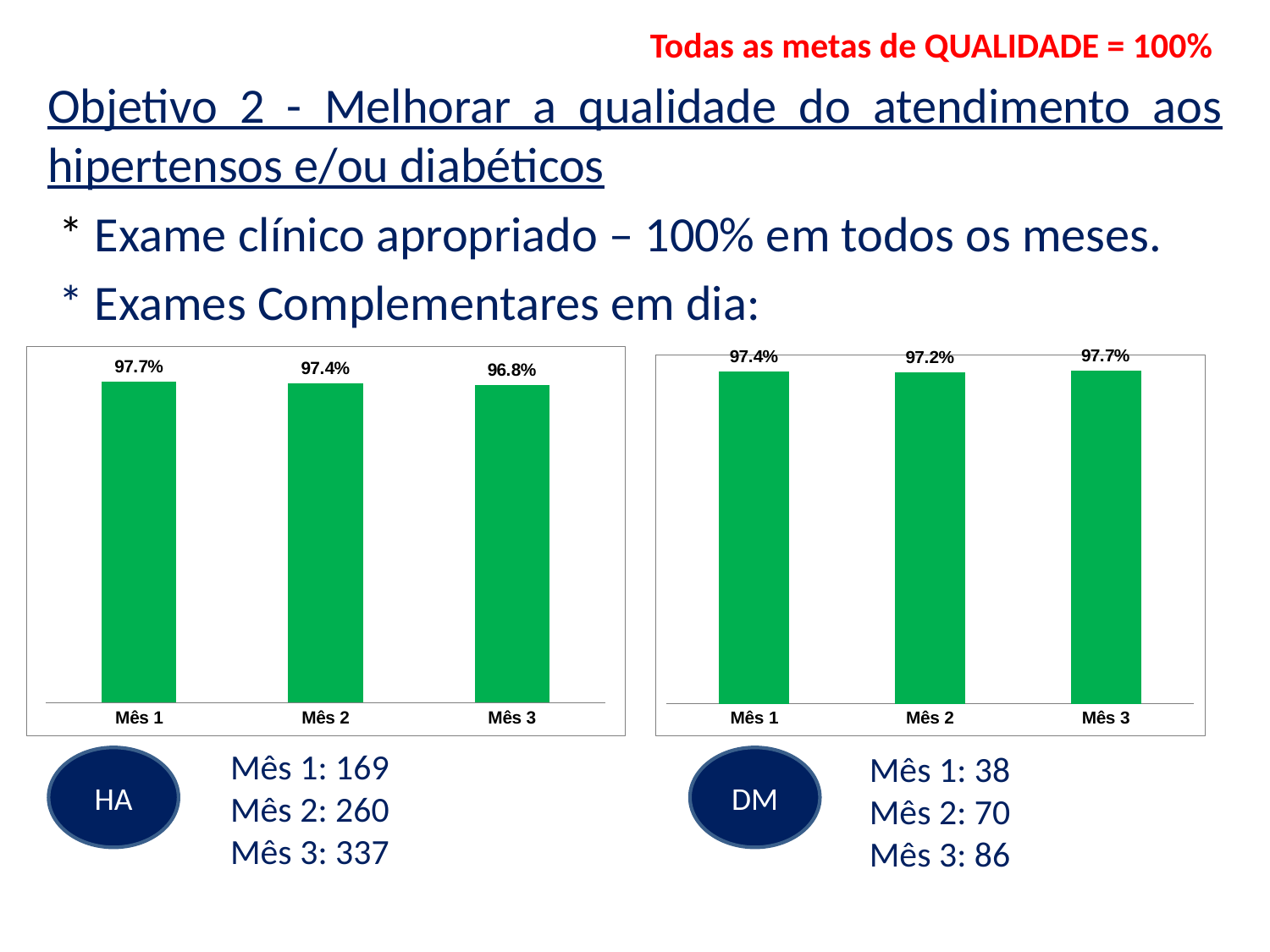
In the right chart (DM), what is the value for Mês 2? 97.2% In the left chart (HA), what is the difference between the values for Mês 1 and Mês 3? 0.9% In the left chart (HA), do the values rise or fall from Mês 1 to Mês 3? fall In the left chart (HA), which month has the lowest value? Mês 3 What type of chart is the left chart (HA)? bar chart How many bars are shown in the right chart (DM)? 3 In the left chart (HA), what is the value for Mês 1? 97.7% In the right chart (DM), which month has the highest value? Mês 3 In the right chart (DM), what is the difference between the values for Mês 3 and Mês 2? 0.5% In the right chart (DM), what is the value for Mês 3? 97.7% In the left chart (HA), what is the value for Mês 3? 96.8% What colour are the bars in both charts? green